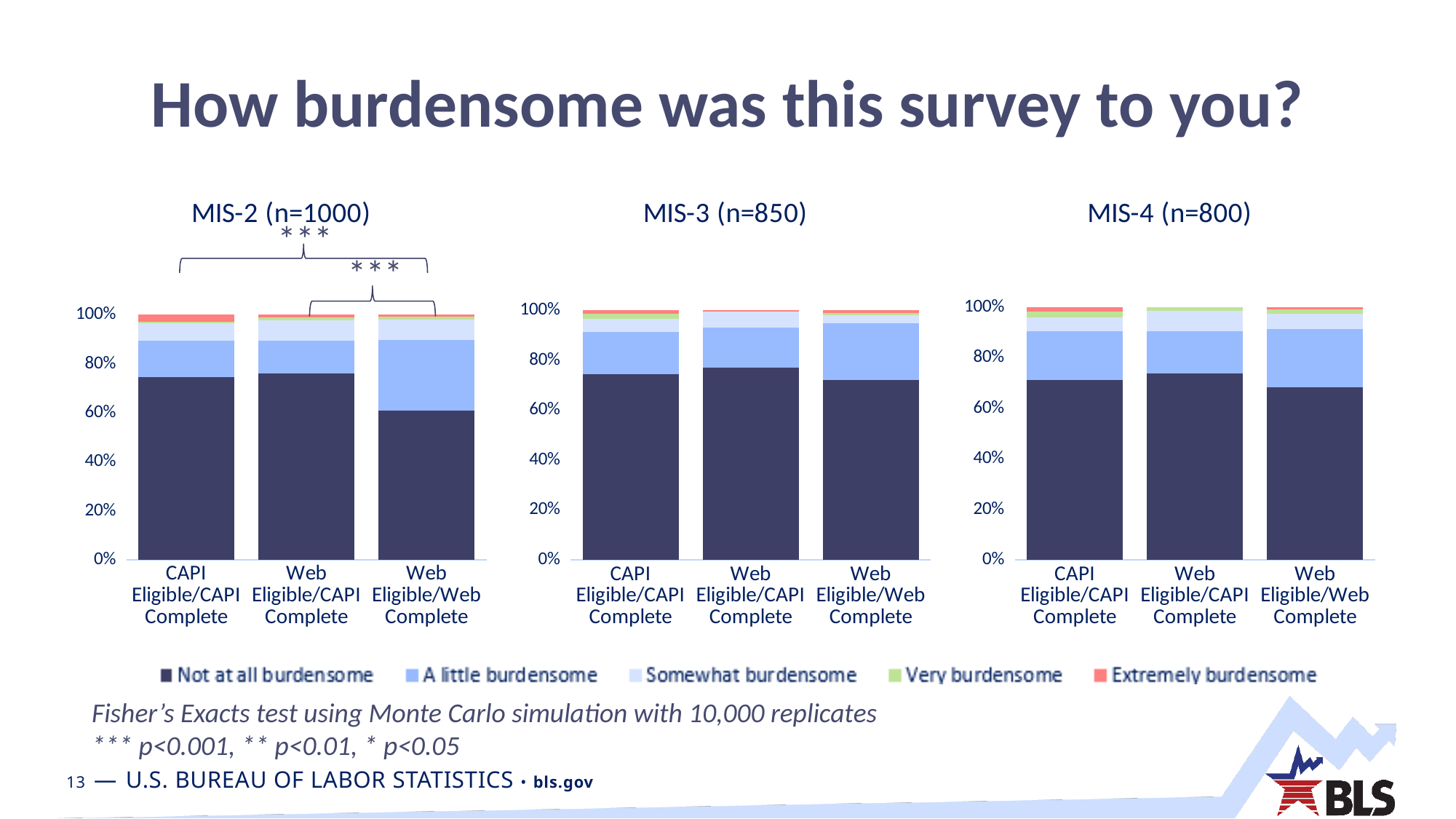
How many series does the legend list? 5 In the MIS-3 (n=850) chart, is the 'Not at all burdensome' share for CAPI Eligible/CAPI Complete greater or less than 60%? greater How many categories are shown on the x axis of the MIS-3 (n=850) chart? 3 Which legend entry is shown in red? Extremely burdensome What kind of chart is used for MIS-2 (n=1000)? Stacked bar chart How many charts are on the slide? 3 In the MIS-2 (n=1000) chart, which category has the lowest share of 'Not at all burdensome'? Web Eligible/Web Complete In the MIS-2 (n=1000) chart, is the 'Not at all burdensome' share for Web Eligible/Web Complete greater or less than 80%? less In the MIS-2 (n=1000) chart, is the 'Not at all burdensome' share for Web Eligible/Web Complete greater or less than 40%? greater In the MIS-2 (n=1000) chart, which has the larger 'Not at all burdensome' share: Web Eligible/CAPI Complete or Web Eligible/Web Complete? Web Eligible/CAPI Complete What is the title of the chart on the right of the slide? MIS-4 (n=800)